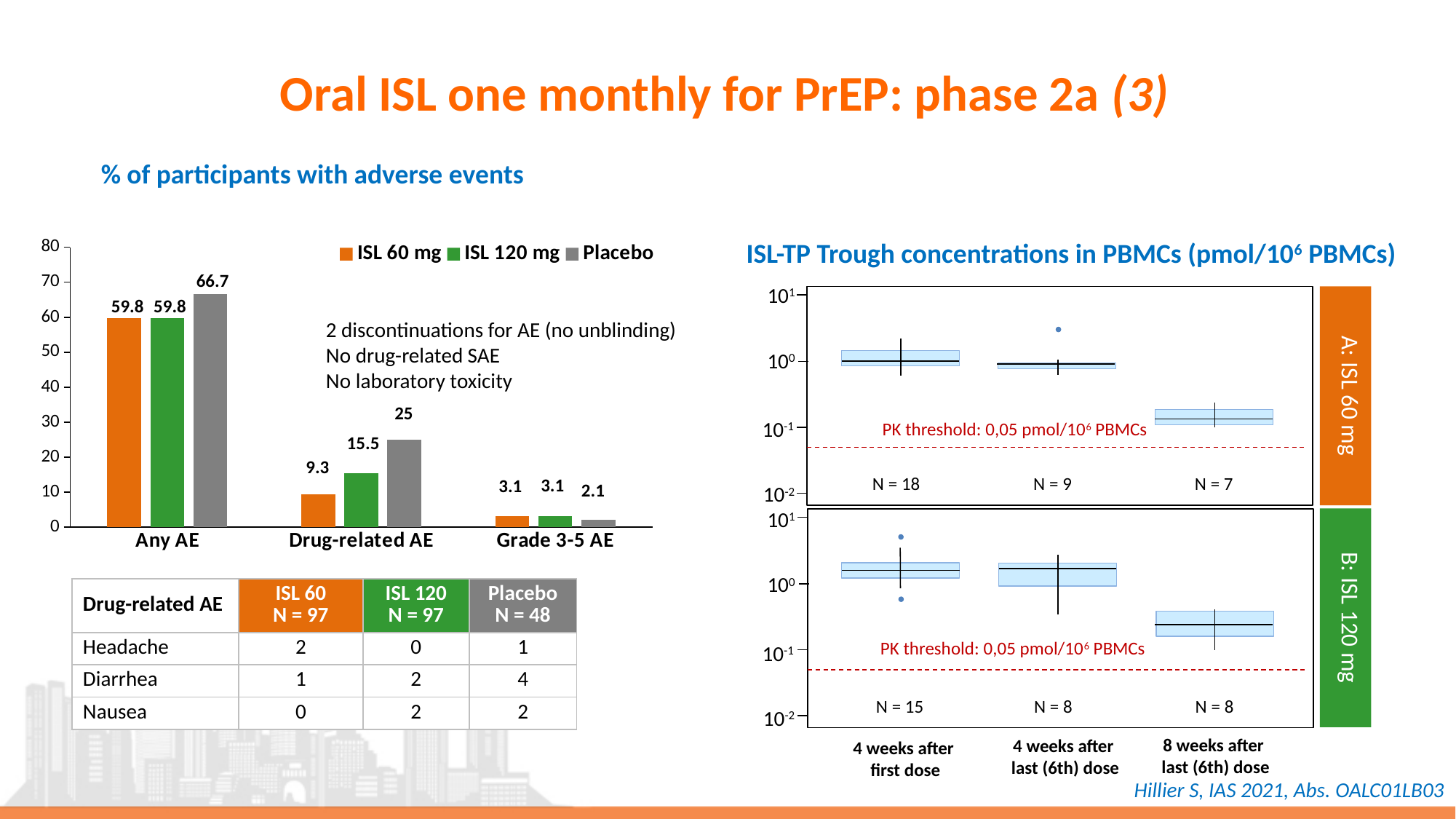
In the '% of participants with adverse events' chart, what is the value for ISL 120 mg in the Drug-related AE category? 15.5 In the ISL-TP Trough concentrations chart, panel B: ISL 120 mg, is the median value at 8 weeks after last (6th) dose greater or less than 10^0? less In the '% of participants with adverse events' chart, what is the difference between the Placebo and ISL 60 mg values in the Drug-related AE category? 15.7 In the '% of participants with adverse events' chart, which is larger in the Any AE category: ISL 60 mg or Placebo? Placebo In the '% of participants with adverse events' chart, what is the value for ISL 60 mg in the Grade 3-5 AE category? 3.1 In the '% of participants with adverse events' chart, which series has the highest value in the Drug-related AE category? Placebo What kind of chart is the '% of participants with adverse events' chart? bar chart In the ISL-TP Trough concentrations chart, what is the N for the 8 weeks after last (6th) dose time point in panel A: ISL 60 mg? N = 7 How many series does the legend of the '% of participants with adverse events' chart list? 3 In the '% of participants with adverse events' chart, which series has the lowest value in the Grade 3-5 AE category? Placebo In the '% of participants with adverse events' chart, what is the value for Placebo in the Any AE category? 66.7 How many categories are shown on the x axis of the '% of participants with adverse events' chart? 3